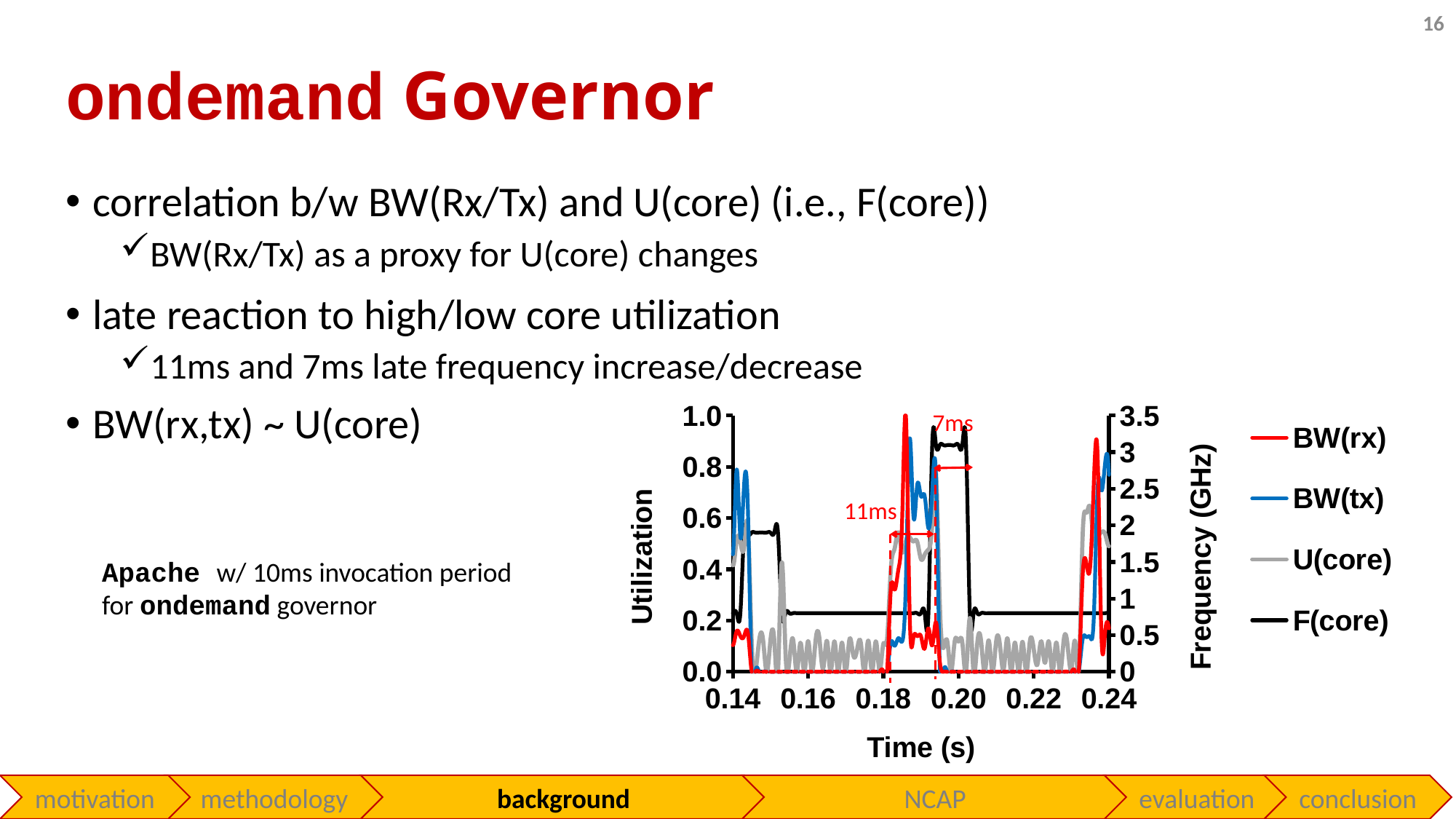
Is the value of BW(rx) at 0.21 s greater or less than 0.2? less What kind of chart is shown on the slide? line chart Is the value of F(core) at 0.17 s greater or less than 1 GHz? less Is the value of U(core) at 0.17 s greater or less than 0.4? less How many series does the chart legend list? 4 Which series is drawn in black in the chart? F(core) According to the annotation on the chart, how late is the frequency increase? 11ms Between 0.16 s and 0.18 s, does F(core) rise, fall, or stay flat? stay flat What is the label of the right-hand vertical axis of the chart? Frequency (GHz) According to the annotation on the chart, how late is the frequency decrease? 7ms